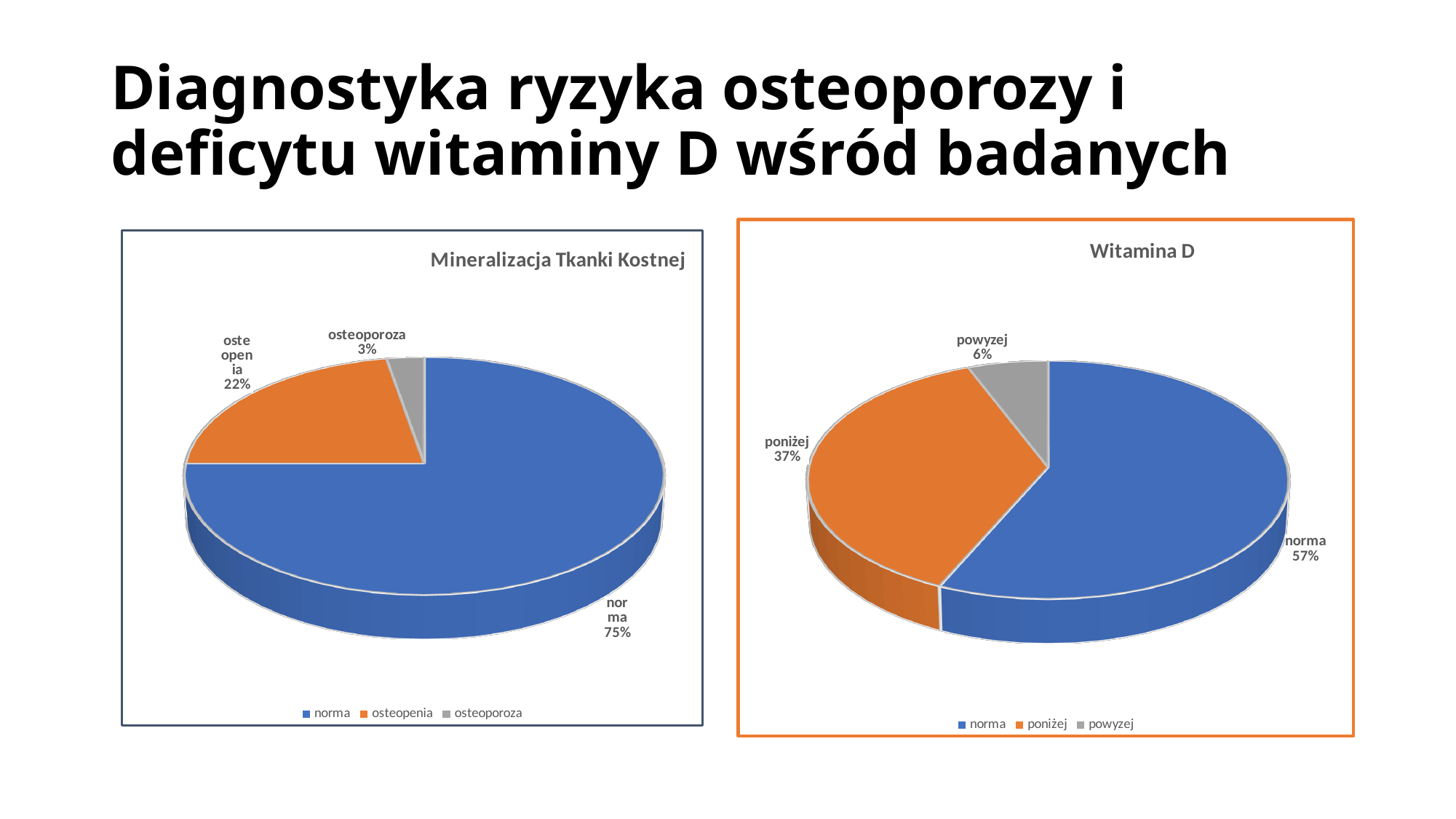
In the 'Mineralizacja Tkanki Kostnej' chart, what share of the pie is 'norma'? 75% In the 'Mineralizacja Tkanki Kostnej' chart, what percentage is shown for 'osteoporoza'? 3% In the 'Mineralizacja Tkanki Kostnej' chart, how many slices does the pie have? 3 What type of chart is the 'Witamina D' chart? pie chart In the 'Mineralizacja Tkanki Kostnej' chart, which category has the smallest slice? osteoporoza In the 'Witamina D' chart, what percentage is shown for 'powyzej'? 6% In the 'Mineralizacja Tkanki Kostnej' chart, how many entries does the legend list? 3 In the 'Witamina D' chart, which category has the largest slice? norma In the 'Witamina D' chart, what share of the pie is 'norma'? 57% In the 'Witamina D' chart, what is the difference in percentage points between 'norma' and 'poniżej'? 20 In the 'Witamina D' chart, what percentage is shown for 'poniżej'? 37% In the 'Mineralizacja Tkanki Kostnej' chart, what percentage is shown for 'osteopenia'? 22%